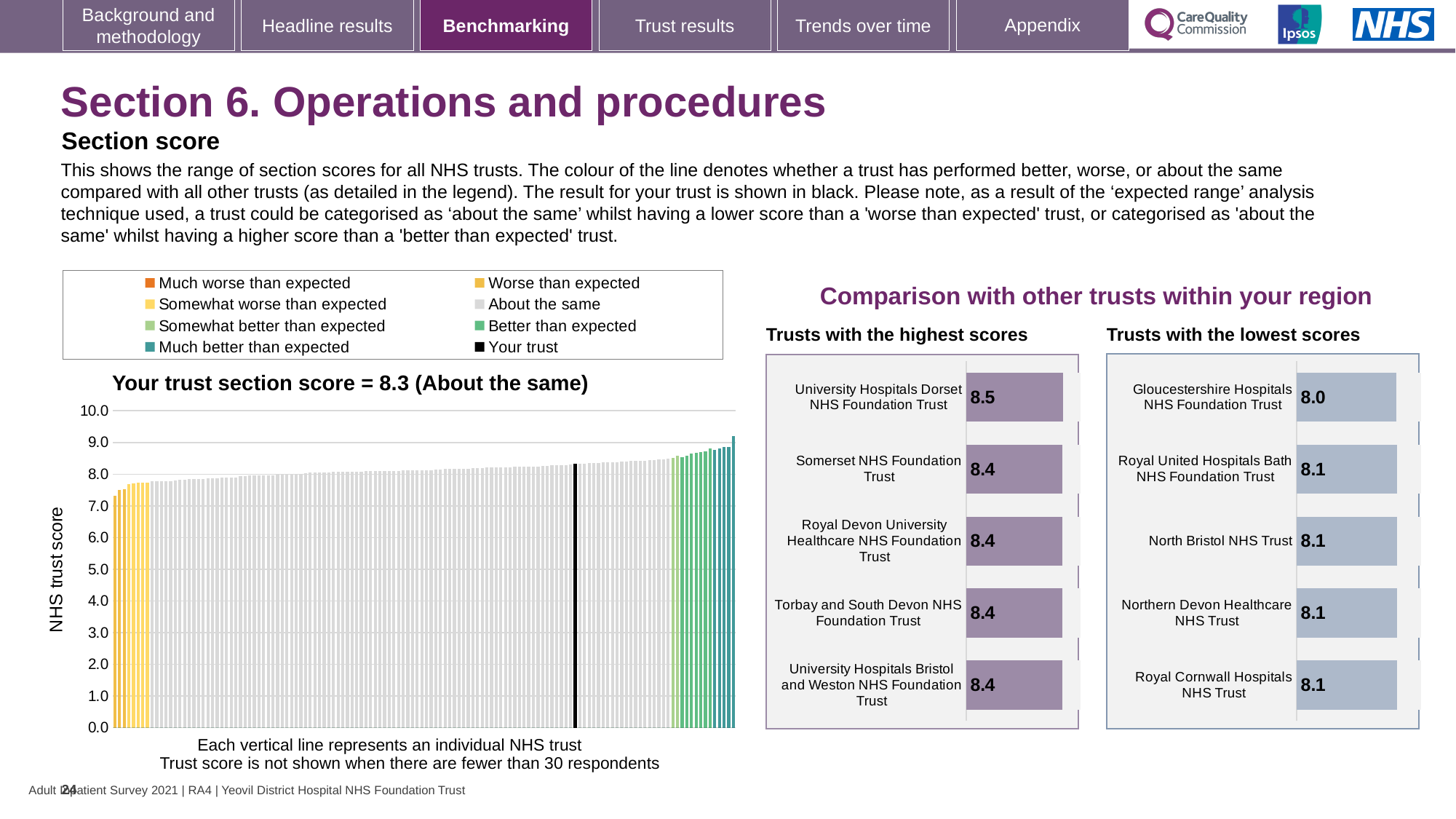
In the 'Trusts with the highest scores' chart, how many trusts are shown? 5 In the 'Your trust section score' chart, what is the section score for your trust? 8.3 In the 'Trusts with the lowest scores' chart, which trust has the lowest score? Gloucestershire Hospitals NHS Foundation Trust In the 'Trusts with the highest scores' chart, which trust has the highest score? University Hospitals Dorset NHS Foundation Trust In the 'Your trust section score' chart, do the bars rise or fall from left to right? rise In the 'Your trust section score' chart, what is the label on the vertical axis? NHS trust score What kind of chart is the 'Your trust section score' chart? bar chart In the 'Your trust section score' chart, is the value of the lowest-scoring trust greater or less than 7.0? greater In the 'Your trust section score' chart, how many entries does the legend list? 8 In the 'Trusts with the lowest scores' chart, what is the score for Gloucestershire Hospitals NHS Foundation Trust? 8.0 In the 'Trusts with the highest scores' chart, what is the score for University Hospitals Dorset NHS Foundation Trust? 8.5 What is the difference between the score for University Hospitals Dorset NHS Foundation Trust in the 'Trusts with the highest scores' chart and the score for Gloucestershire Hospitals NHS Foundation Trust in the 'Trusts with the lowest scores' chart? 0.5